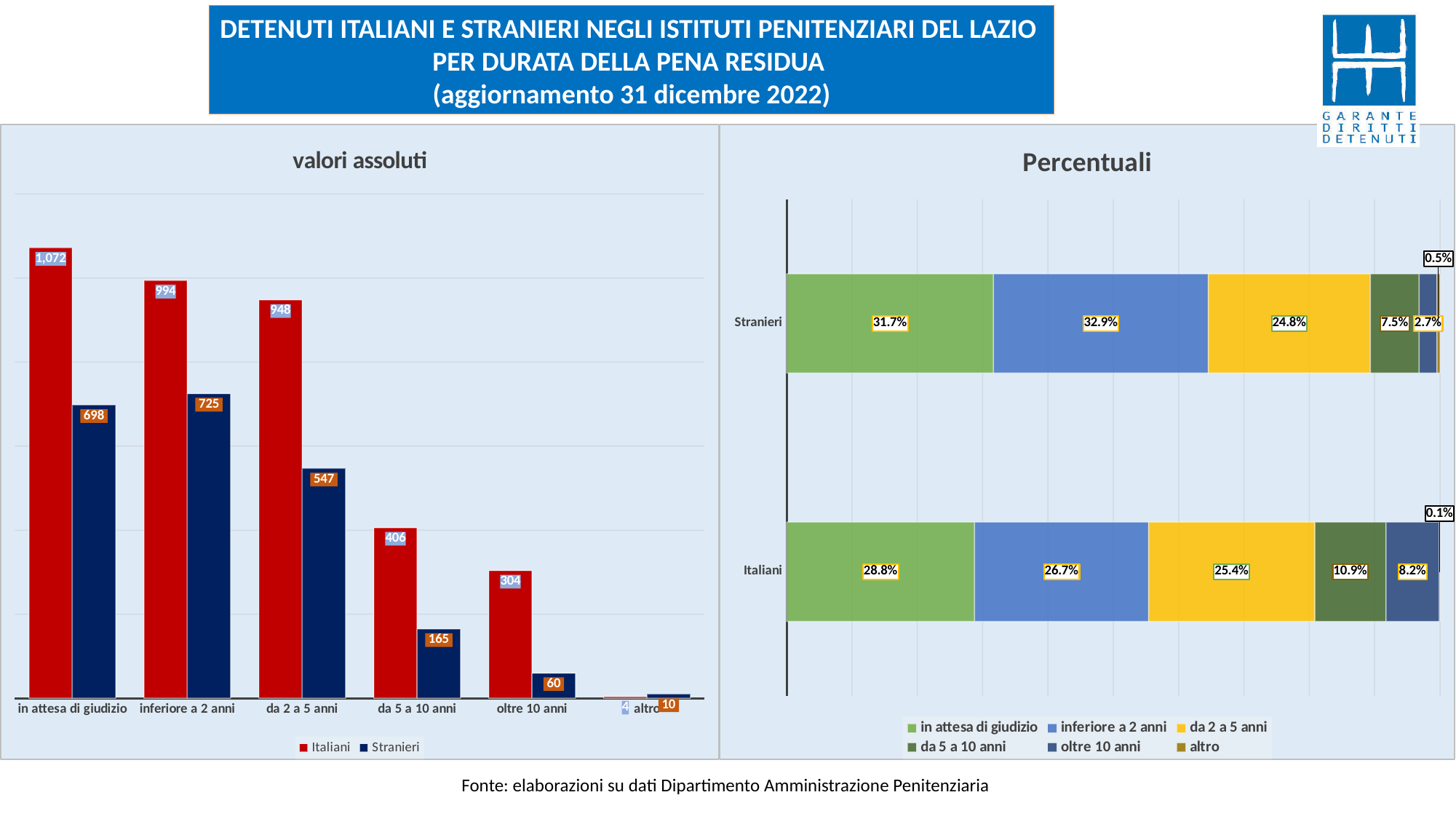
In the 'Percentuali' chart, what is the share for 'inferiore a 2 anni' in the Stranieri bar? 32.9% In the 'valori assoluti' chart, which is larger in the 'oltre 10 anni' category, Italiani or Stranieri? Italiani How many series does the legend of the 'valori assoluti' chart list? 2 In the 'valori assoluti' chart, what is the value for Stranieri in the 'inferiore a 2 anni' category? 725 How many series does the legend of the 'Percentuali' chart list? 6 How many categories are shown on the x axis of the 'valori assoluti' chart? 6 In the 'valori assoluti' chart, which category has the lowest value for Italiani? altro In the 'valori assoluti' chart, what is the value for Italiani in the 'in attesa di giudizio' category? 1,072 What kind of chart is the 'Percentuali' chart? stacked bar chart In the 'Percentuali' chart, what is the share for 'oltre 10 anni' in the Italiani bar? 8.2% In the 'valori assoluti' chart, what is the difference between Italiani and Stranieri in the 'da 2 a 5 anni' category? 401 In the 'valori assoluti' chart, which category has the highest value for Stranieri? inferiore a 2 anni